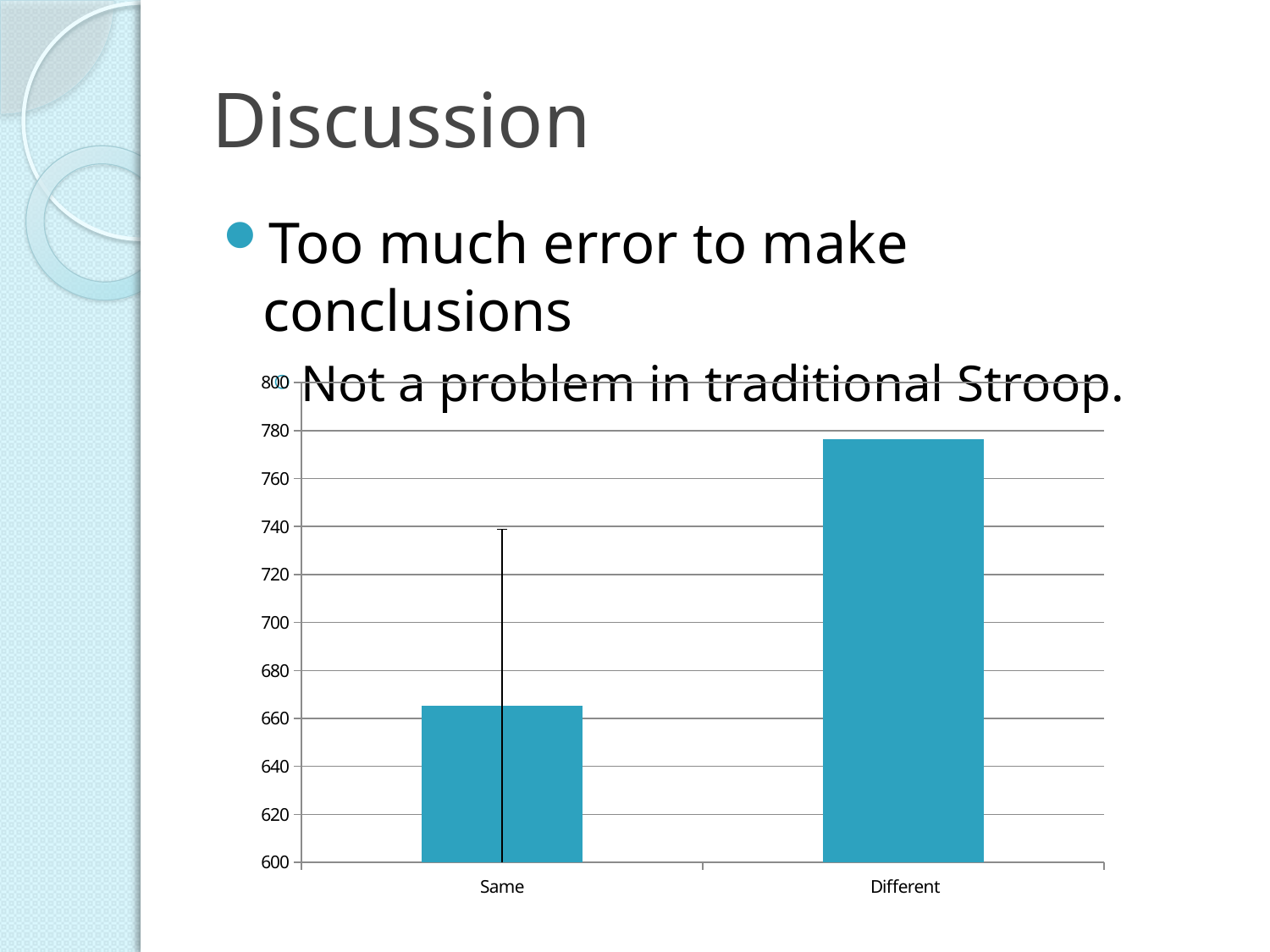
Which bar in the chart has an error bar drawn on it? Same What is the lowest value shown on the chart's vertical axis? 600 Is the value for Different greater or less than 760? greater How many categories are plotted on the x axis of the chart? 2 Which category has the highest bar in the chart? Different Is the value for Same greater or less than 680? less Which category has the lowest bar in the chart? Same Is the value for Same greater or less than 700? less Which bar is taller, Same or Different? Different What kind of chart is shown on the slide? bar chart